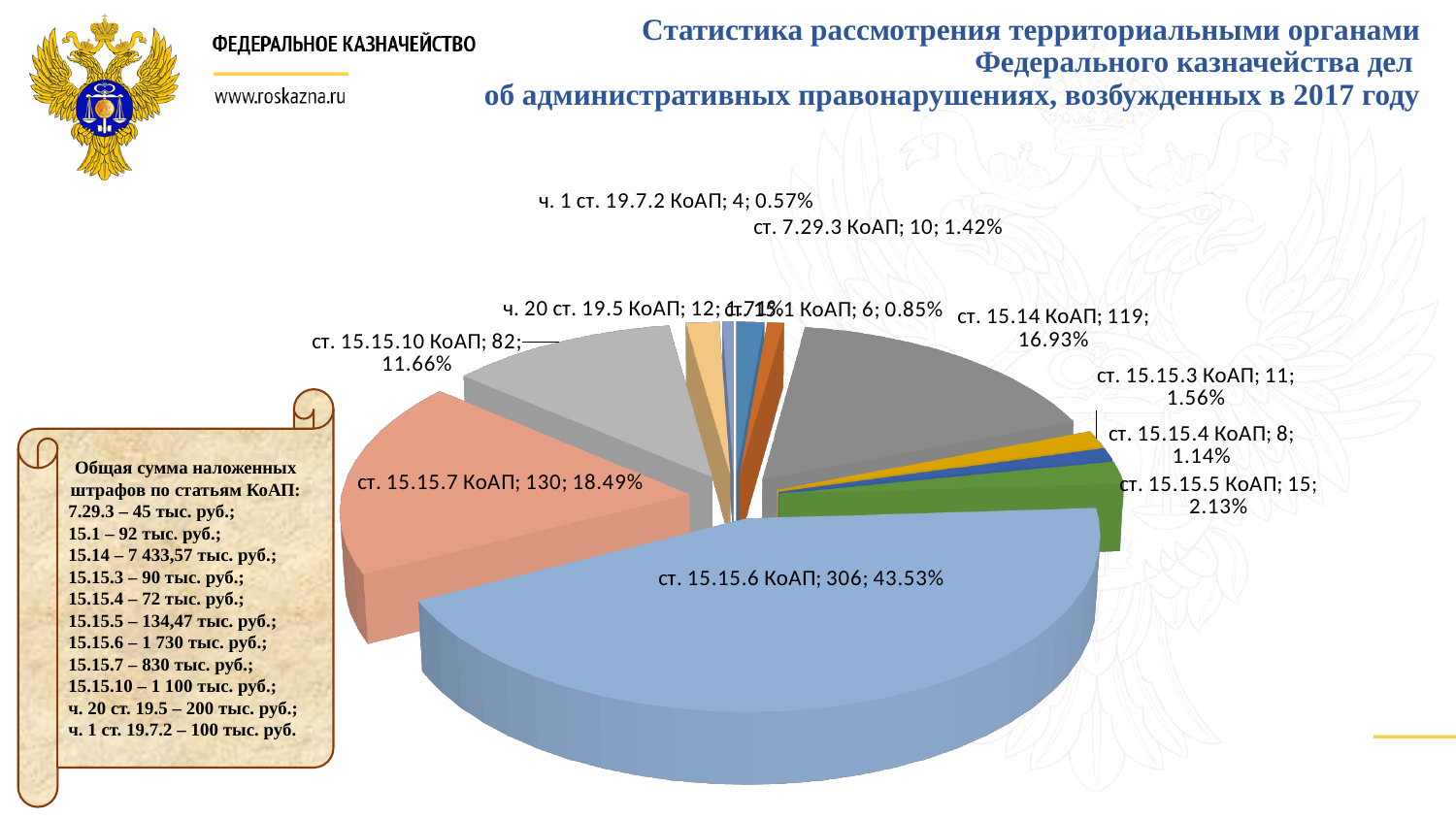
What percentage share does ст. 15.15.10 КоАП have? 11.66% What is the difference in the number of cases between ст. 15.15.6 КоАП and ст. 15.15.7 КоАП? 176 Which has more cases: ст. 15.15.5 КоАП or ст. 15.15.3 КоАП? ст. 15.15.5 КоАП What kind of chart is shown on the slide? pie chart What percentage share does ст. 15.15.7 КоАП have in the pie chart? 18.49% Which article has the largest share of cases in the pie chart? ст. 15.15.6 КоАП How many cases are shown for ст. 15.15.6 КоАП? 306 How many categories (slices) does the pie chart have? 11 How many cases are shown for ст. 15.14 КоАП? 119 Which year do the administrative cases in the chart title refer to? 2017 Which article has the smallest number of cases in the pie chart? ч. 1 ст. 19.7.2 КоАП How many cases are shown for ст. 7.29.3 КоАП? 10